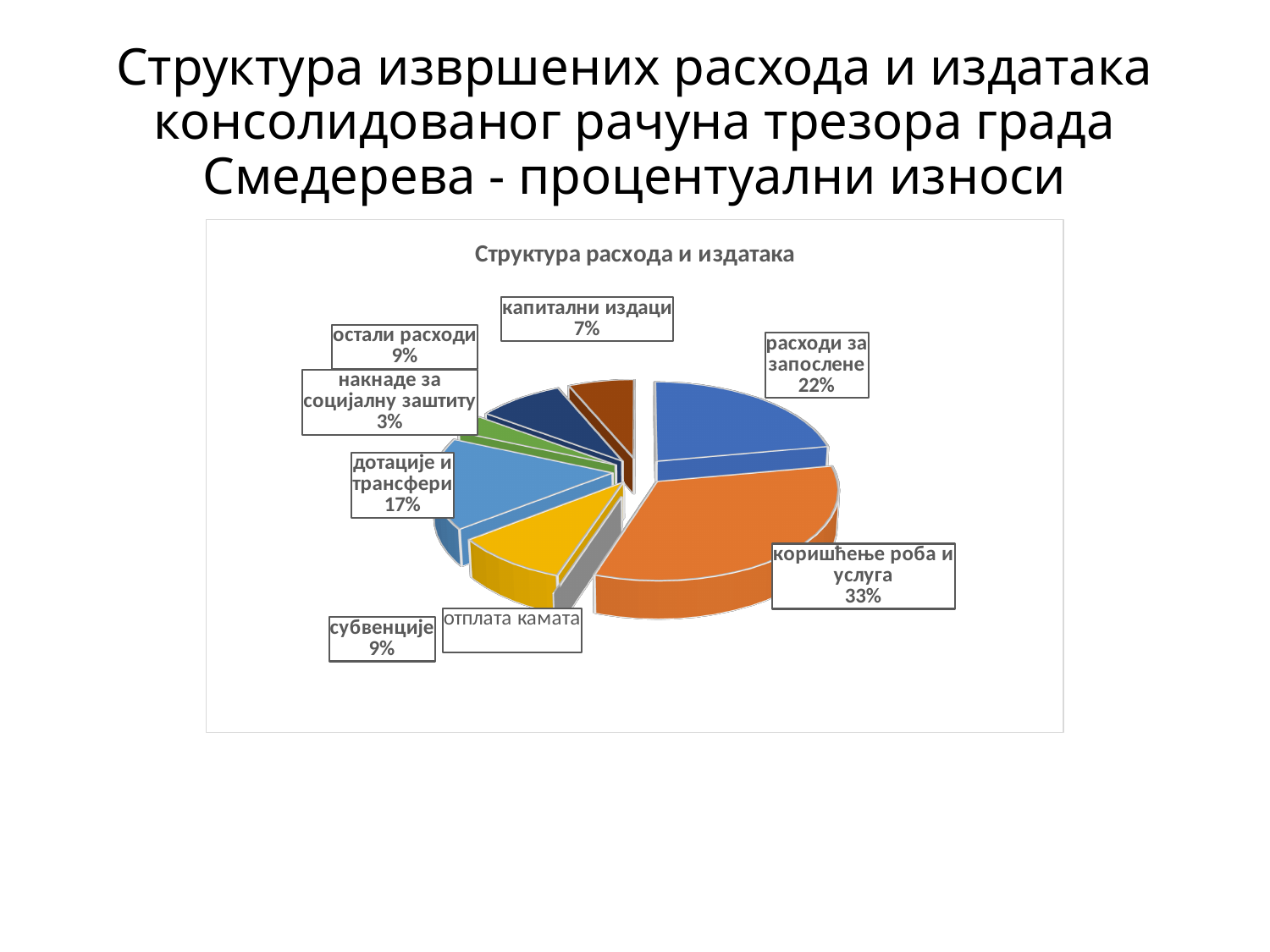
Which category with a printed percentage has the smallest slice of the pie? накнаде за социјалну заштиту What is the difference in percentage points between коришћење роба и услуга and расходи за запослене? 11 What kind of chart is shown on the slide? pie chart How many categories are labelled on the pie chart? 8 What share of the pie is дотације и трансфери? 17% What share of the pie is расходи за запослене? 22% Which is larger, the share for дотације и трансфери or the share for субвенције? дотације и трансфери What is the title of the chart? Структура расхода и издатака What share of the pie is коришћење роба и услуга? 33% Which category has the largest slice of the pie? коришћење роба и услуга